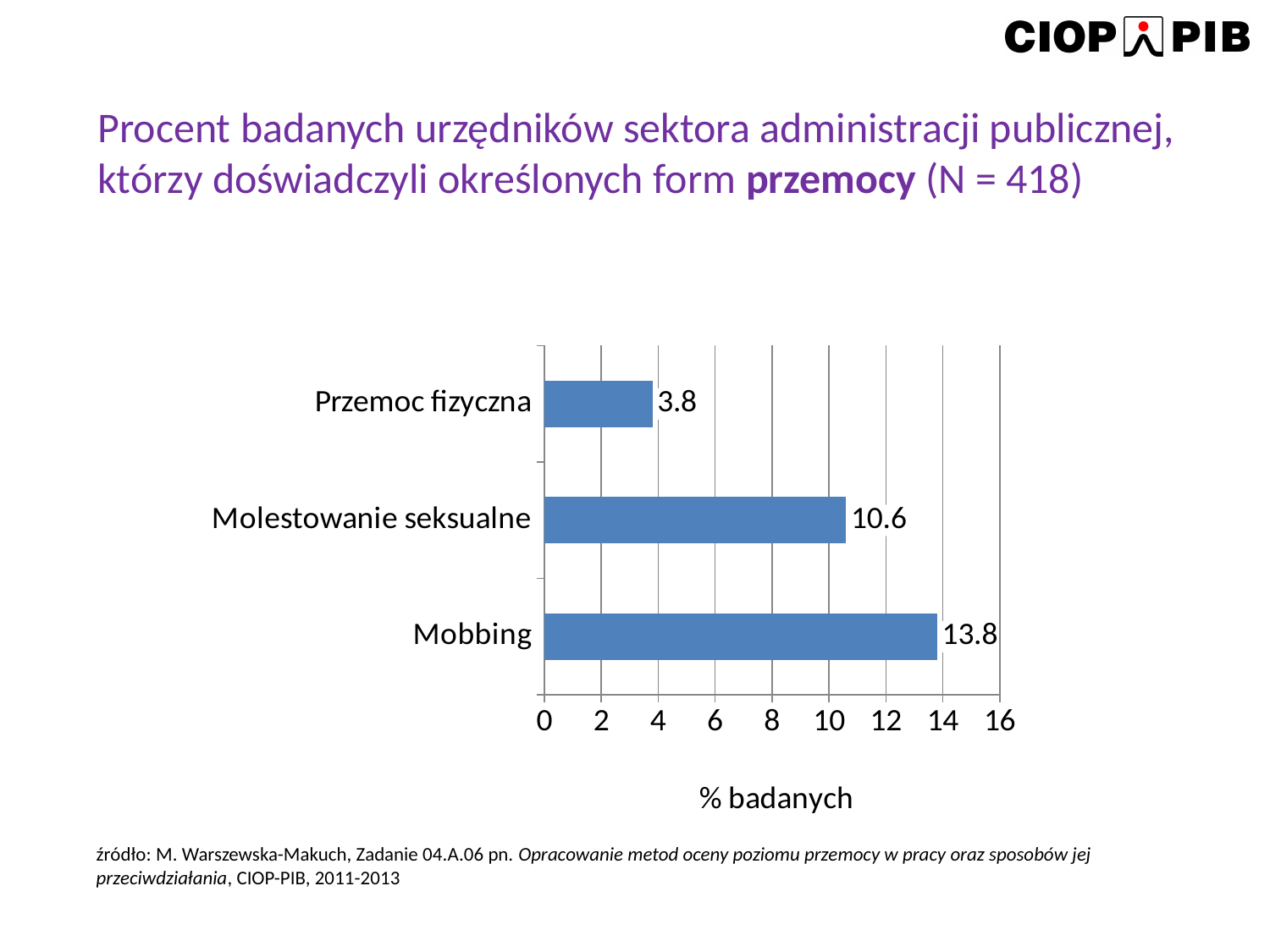
What kind of chart is shown on the slide? bar chart What is the value for Molestowanie seksualne? 10.6 What is the value for Mobbing? 13.8 Which is larger, the value for Molestowanie seksualne or the value for Przemoc fizyczna? Molestowanie seksualne Which category has the lowest value? Przemoc fizyczna How many categories are shown in the chart? 3 What is the difference between the values for Mobbing and Przemoc fizyczna? 10.0 Which category has the highest value? Mobbing What is the label of the horizontal axis? % badanych What is the difference between the values for Mobbing and Molestowanie seksualne? 3.2 Is the value for Molestowanie seksualne greater or less than 8? greater What is the value for Przemoc fizyczna? 3.8